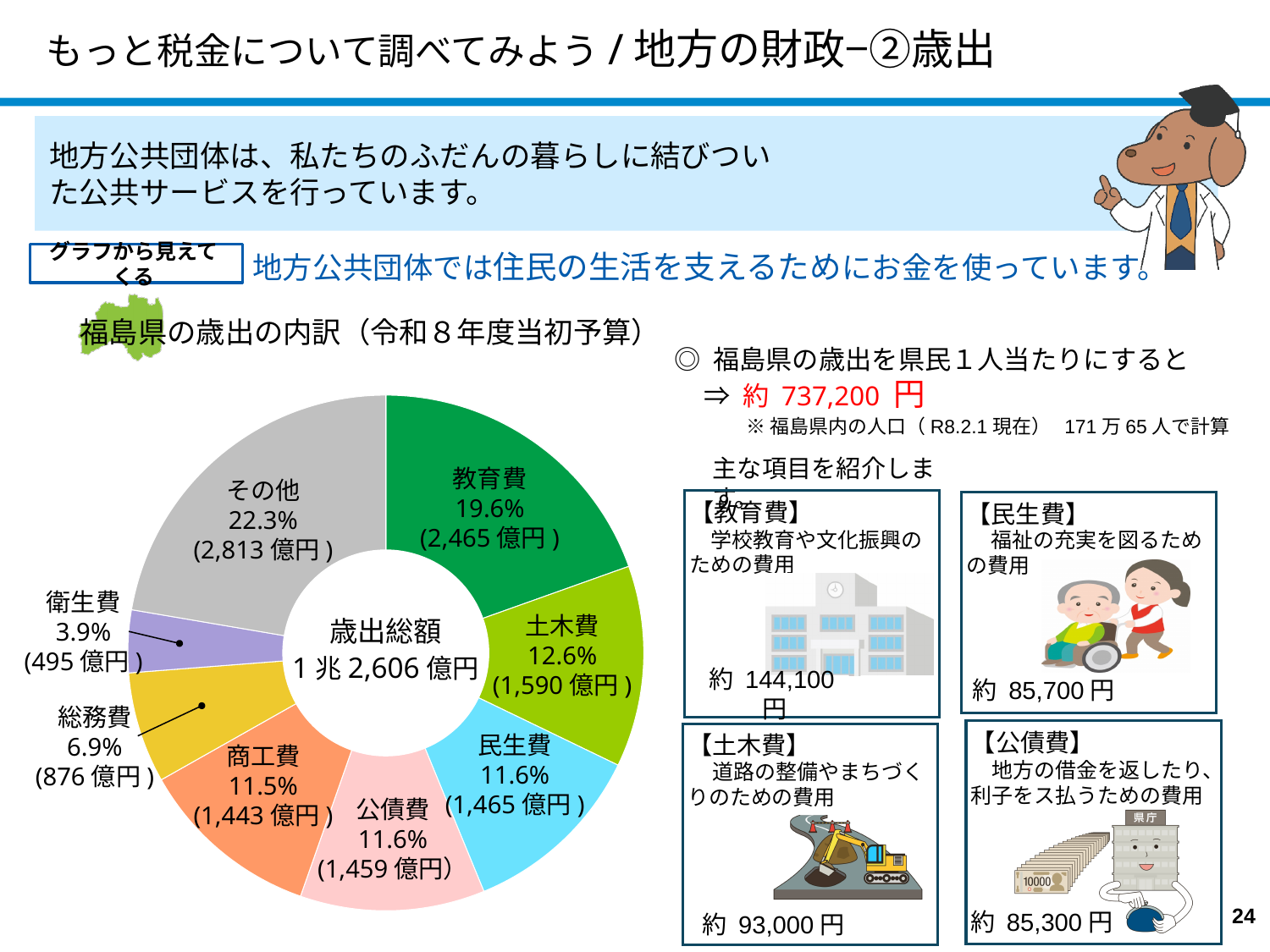
What percentage of Fukushima Prefecture's expenditure is 教育費? 19.6% What is the amount shown for 土木費 in the expenditure chart? 1,590 億円 What is the difference in percentage points between 商工費 (11.5%) and 総務費 (6.9%)? 4.6 percentage points What is the amount shown for 総務費? 876 億円 Which category has the largest share in the expenditure chart? その他 (22.3%) What is the title of the expenditure chart? 福島県の歳出の内訳（令和８年度当初予算） Which category has the smallest share in the expenditure chart? 衛生費 (3.9%) What percentage share does 衛生費 have in the expenditure chart? 3.9% How many categories are shown in the expenditure chart? 8 Which is larger, the share of 教育費 or the share of 土木費? 教育費 What kind of chart is used to show the breakdown of Fukushima Prefecture's expenditure? Pie (donut) chart What is the total expenditure (歳出総額) shown in the centre of the chart? 1 兆 2,606 億円